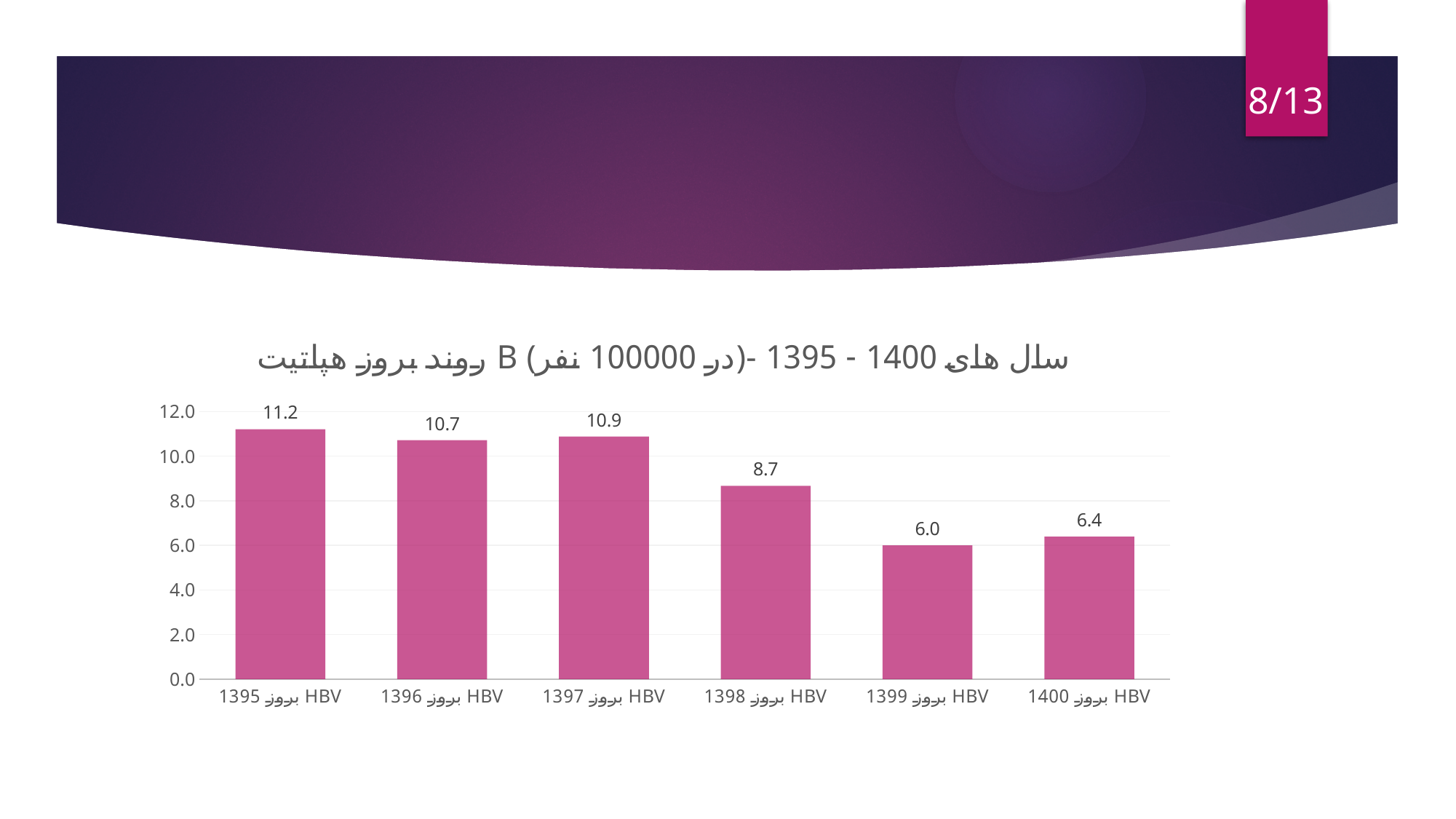
What is the value for HBV incidence in 1400? 6.4 What kind of chart is shown on the slide? bar chart What is the value for HBV incidence in 1398? 8.7 What is the difference between the HBV incidence in 1397 and in 1398? 2.2 Which year has the highest HBV incidence? 1395 Is the value for HBV incidence in 1398 greater or less than 10.0? less What is the difference between the HBV incidence in 1395 and in 1400? 4.8 Which year has the lowest HBV incidence? 1399 How many years are shown on the x axis? 6 What is the value for HBV incidence in 1395? 11.2 Do the values generally rise or fall from 1395 to 1400? fall Which is larger, the HBV incidence in 1396 or in 1397? 1397